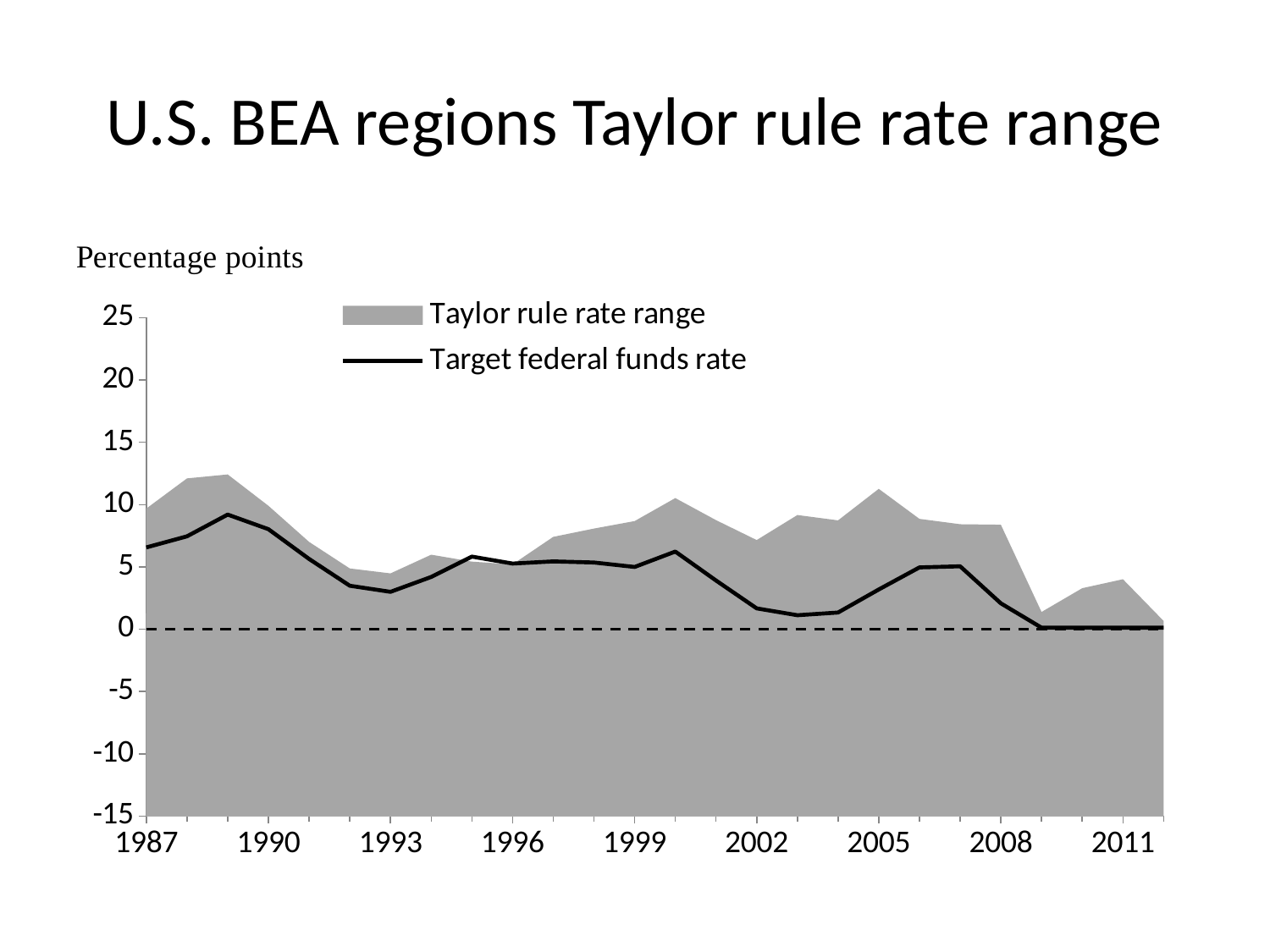
Is the target federal funds rate in 1987 greater or less than 10? less In which year does the target federal funds rate reach its highest value? 1989 What is the title of the chart? U.S. BEA regions Taylor rule rate range Is the target federal funds rate in 1989 greater or less than 5? greater Is the upper edge of the Taylor rule rate range in 2005 greater or less than 10? greater What unit is shown on the vertical axis label? Percentage points How many series does the legend list? 2 Does the target federal funds rate rise or fall between 2007 and 2009? fall Does the target federal funds rate rise or fall between 2003 and 2006? rise